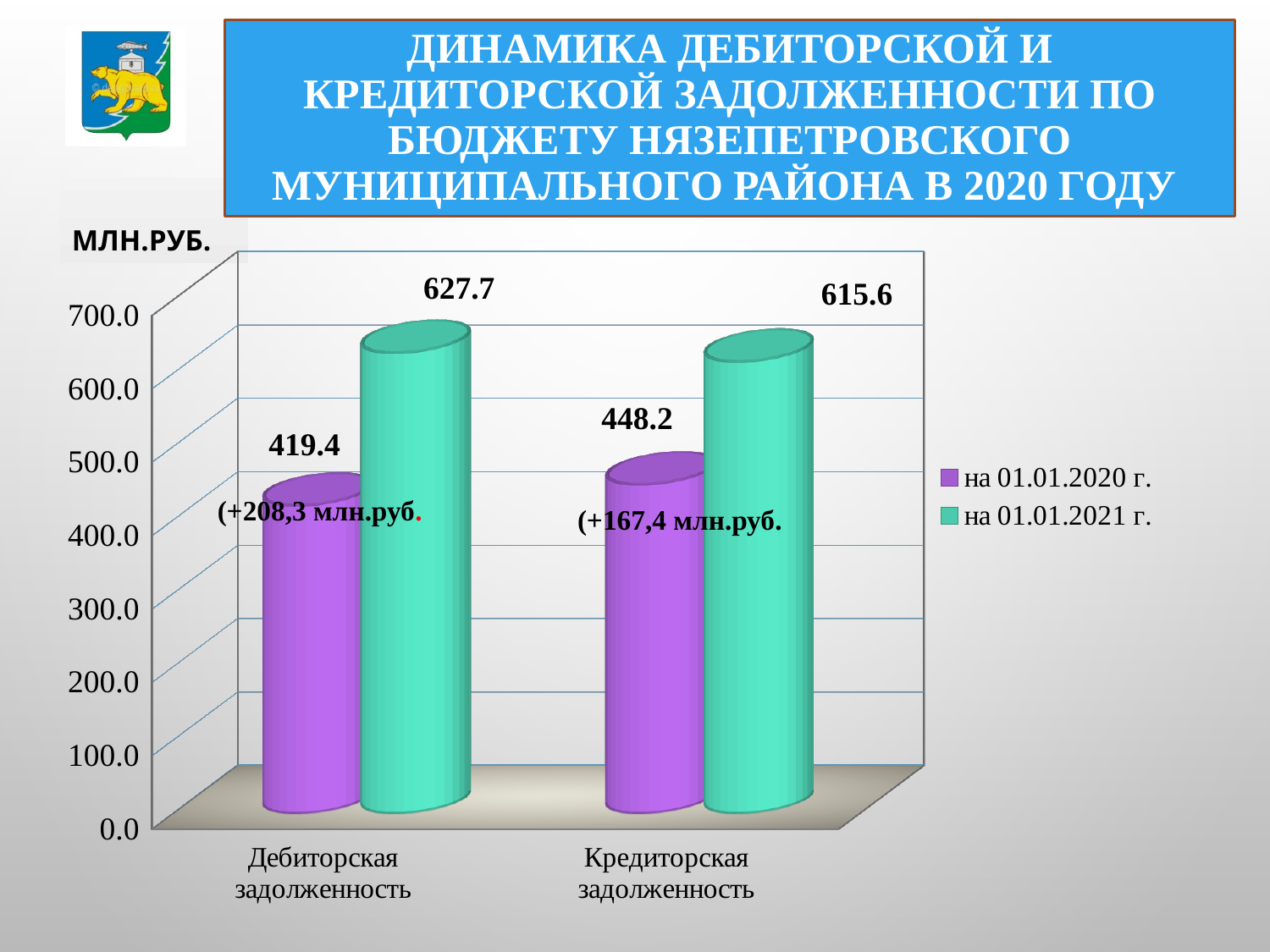
What is the value for Дебиторская задолженность on 01.01.2020 г.? 419.4 What is the value for Кредиторская задолженность on 01.01.2021 г.? 615.6 What is the difference between the 01.01.2021 г. and 01.01.2020 г. values for Кредиторская задолженность? 167.4 How many categories are shown on the x axis? 2 How many series does the legend list? 2 Which category has the highest value on 01.01.2021 г.? Дебиторская задолженность What is the value for Дебиторская задолженность on 01.01.2021 г.? 627.7 What kind of chart is shown on the slide? Bar chart What is the value for Кредиторская задолженность on 01.01.2020 г.? 448.2 What is the difference between the 01.01.2021 г. and 01.01.2020 г. values for Дебиторская задолженность? 208.3 Which category has the lowest value on 01.01.2020 г.? Дебиторская задолженность Which is larger: Кредиторская задолженность on 01.01.2020 г. or Дебиторская задолженность on 01.01.2020 г.? Кредиторская задолженность on 01.01.2020 г.